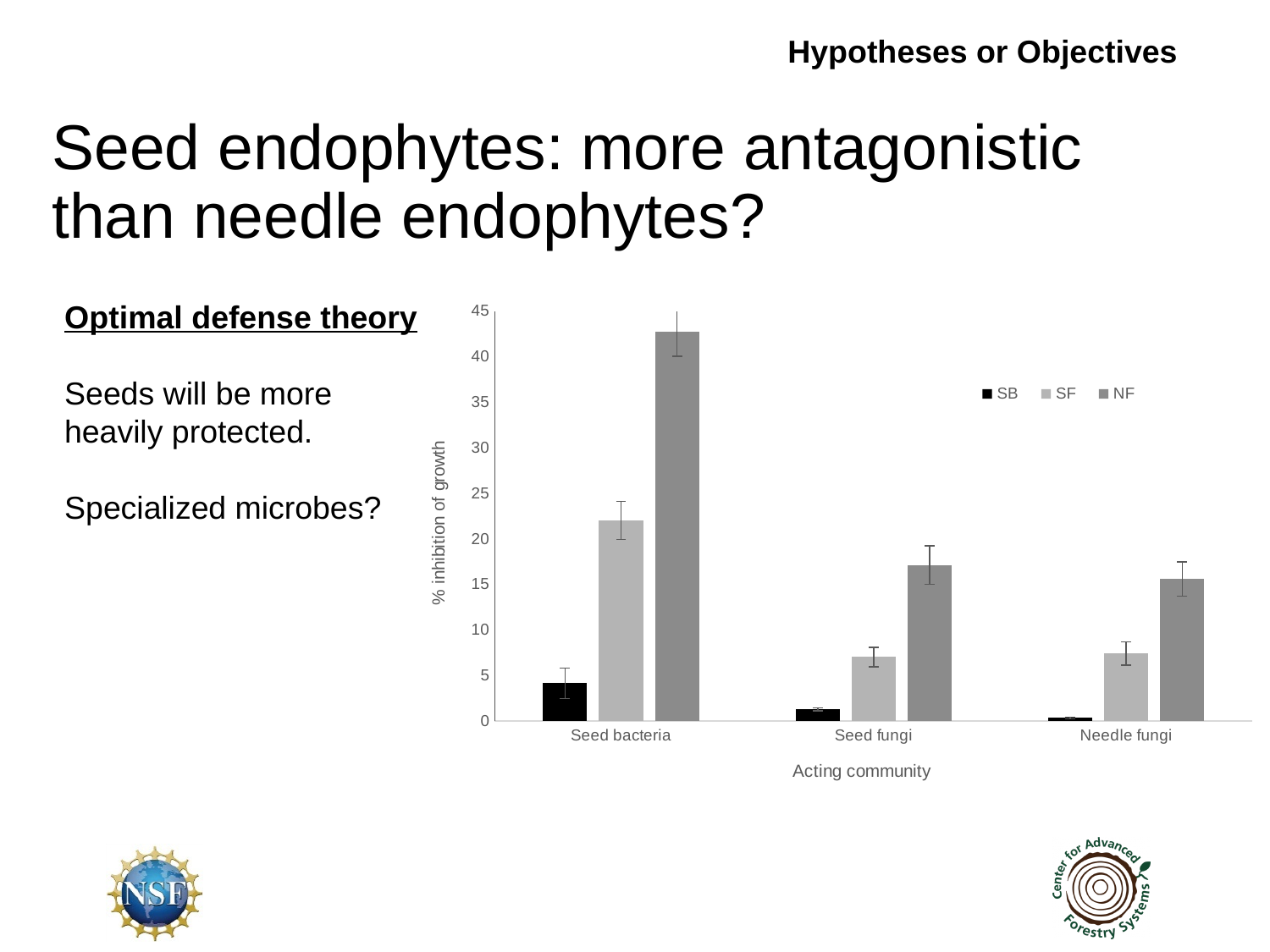
How many categories are shown on the x axis of the chart? 3 Which series has the lowest bar in the Seed fungi category? SB Is the NF value for Seed bacteria greater or less than 40? greater Which is larger: the SF value for Seed bacteria or the SF value for Needle fungi? Seed bacteria What kind of chart is shown on the slide? bar chart Across all categories, which category has the tallest NF bar? Seed bacteria How many series does the chart legend list? 3 Which series has the highest bar in the Seed bacteria category? NF What is the title of the y axis of the chart? % inhibition of growth Is the SB value for Seed bacteria greater or less than 10? less What is the title of the x axis of the chart? Acting community Is the NF value for Needle fungi greater or less than 10? greater